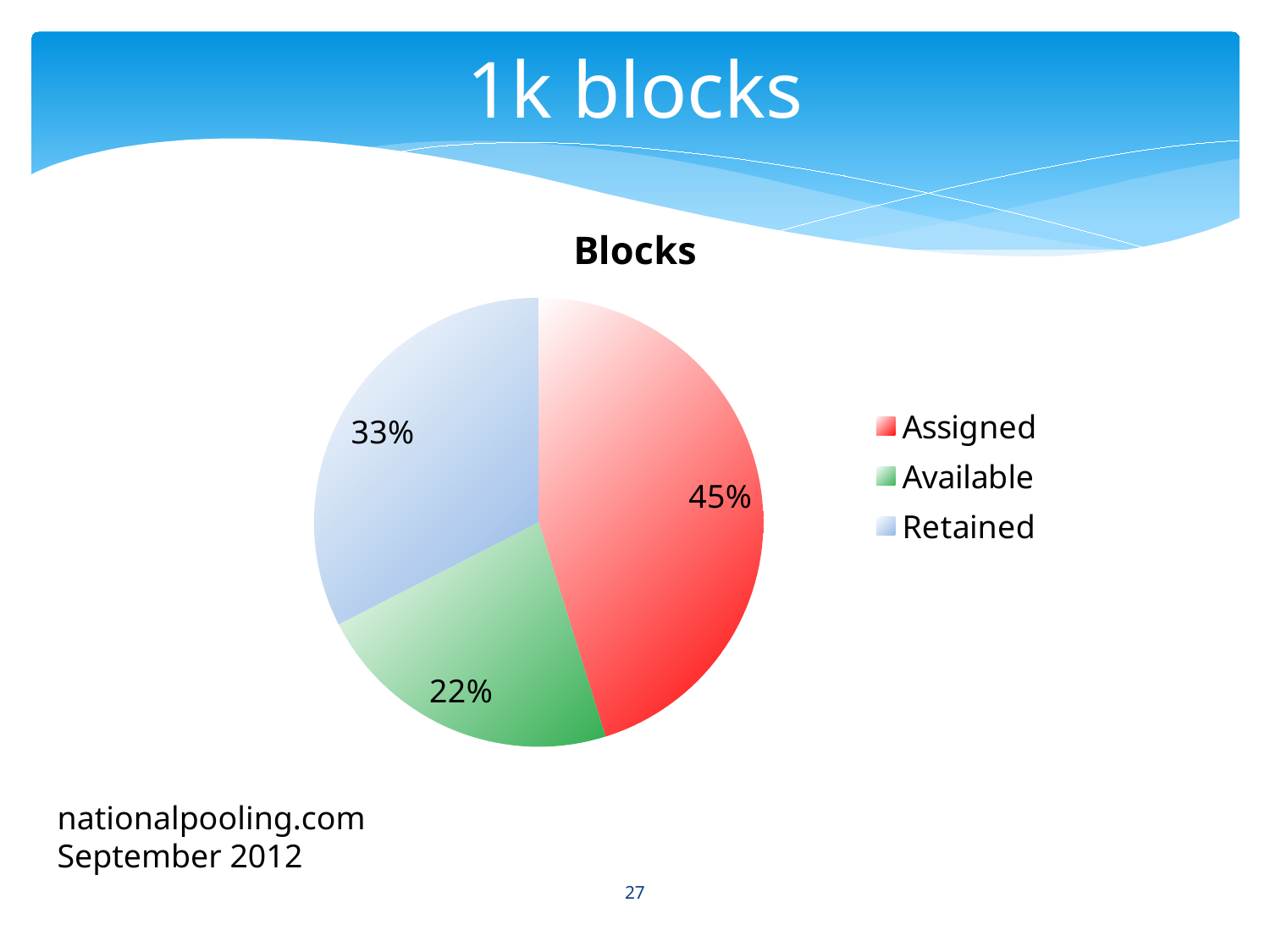
Which category has the largest share of the pie? Assigned What is the difference in percentage points between the Retained and Available shares? 11 Which colour represents Available in the legend? green What is the difference in percentage points between the Assigned and Retained shares? 12 What share of the pie is Assigned? 45% What share of the pie is Retained? 33% What share of the pie is Available? 22% Which is larger, the Retained share or the Available share? Retained How many categories does the pie chart have? 3 What type of chart is shown on the slide? pie chart Which category has the smallest share of the pie? Available What is the title of the chart? Blocks